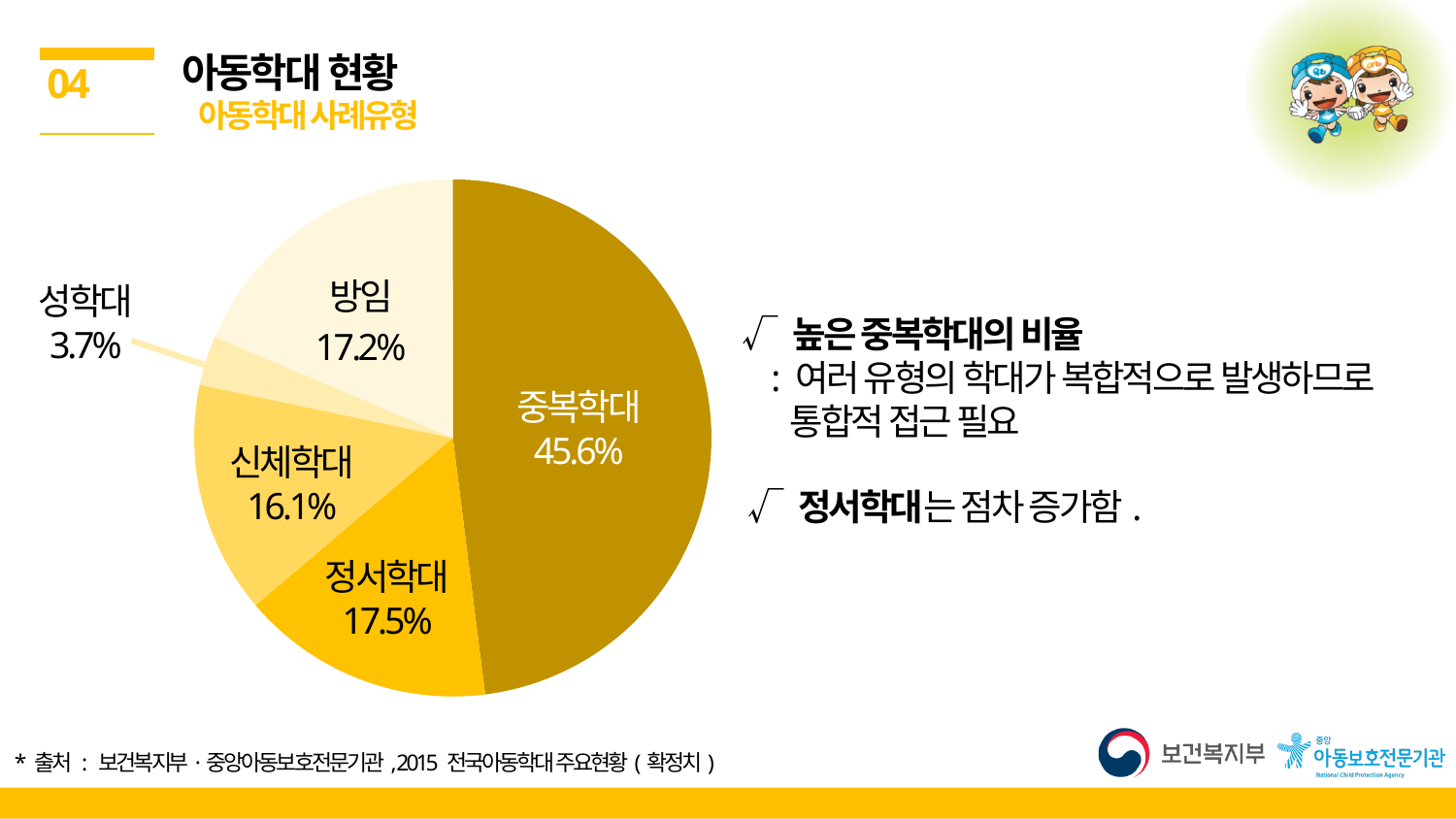
What is the difference between the values for 신체학대 and 성학대? 12.4% What type of chart is shown on the slide? pie chart What is the value shown for 신체학대? 16.1% What is the value shown for 정서학대? 17.5% Which category has the smallest slice of the pie? 성학대 Which category has the largest slice of the pie? 중복학대 What share of the pie does 중복학대 represent? 45.6% How many categories are shown in the pie chart? 5 What is the value shown for 방임? 17.2% What is the value shown for 성학대? 3.7% Which is larger, the value for 신체학대 or the value for 성학대? 신체학대 What is the difference between the values for 중복학대 and 정서학대? 28.1%